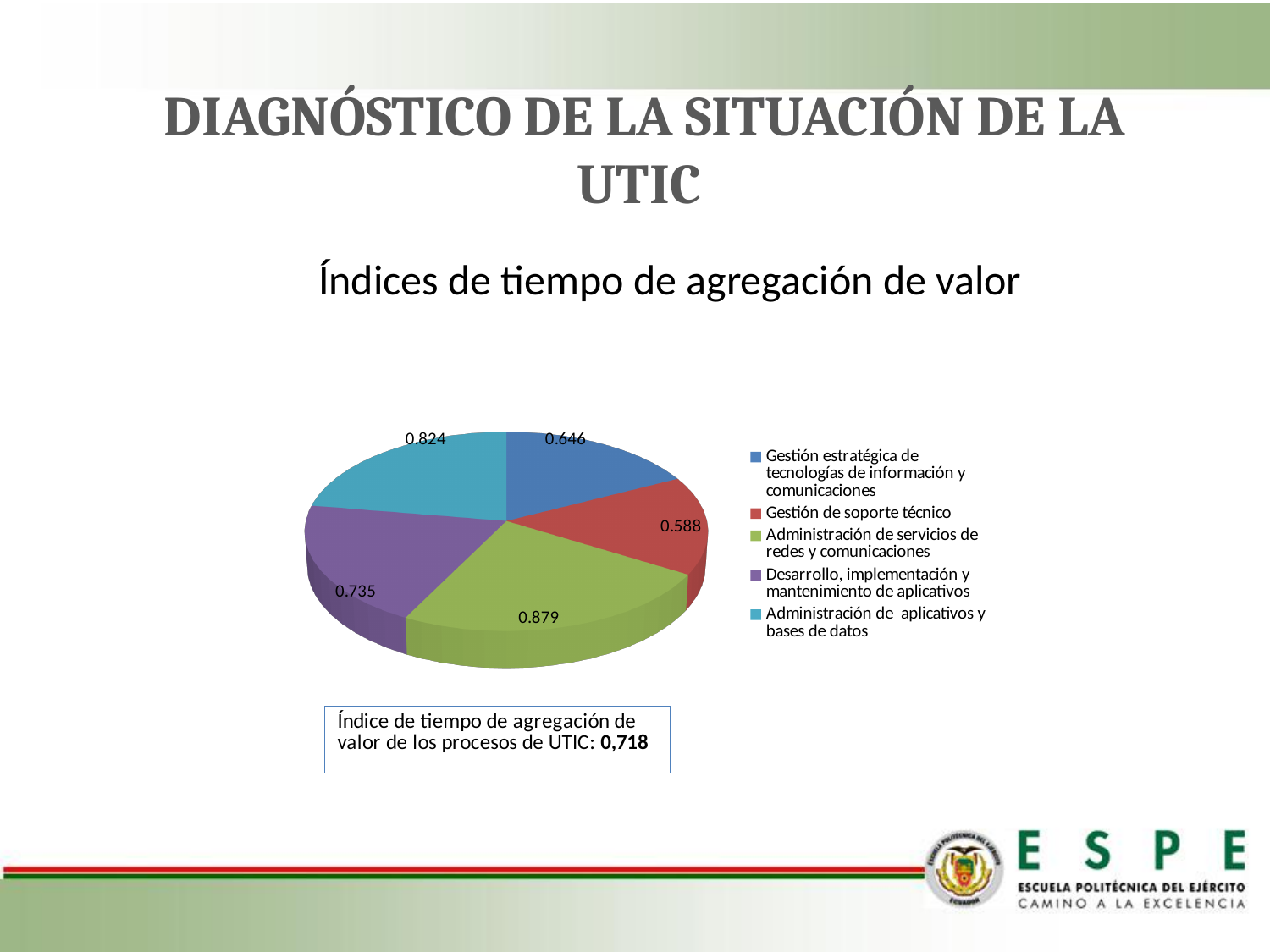
What colour is the slice for Gestión de soporte técnico? red Which category has the lowest value? Gestión de soporte técnico What kind of chart is shown on the slide? pie chart What is the value for Gestión de soporte técnico? 0.588 What is the value for Gestión estratégica de tecnologías de información y comunicaciones? 0.646 What is the value for Desarrollo, implementación y mantenimiento de aplicativos? 0.735 What is the difference between the values for Administración de servicios de redes y comunicaciones and Gestión de soporte técnico? 0.291 How many categories does the pie chart have? 5 Which category has the highest value? Administración de servicios de redes y comunicaciones Which is larger, the value for Administración de aplicativos y bases de datos or the value for Desarrollo, implementación y mantenimiento de aplicativos? Administración de aplicativos y bases de datos What is the value for Administración de aplicativos y bases de datos? 0.824 What is the value for Administración de servicios de redes y comunicaciones? 0.879